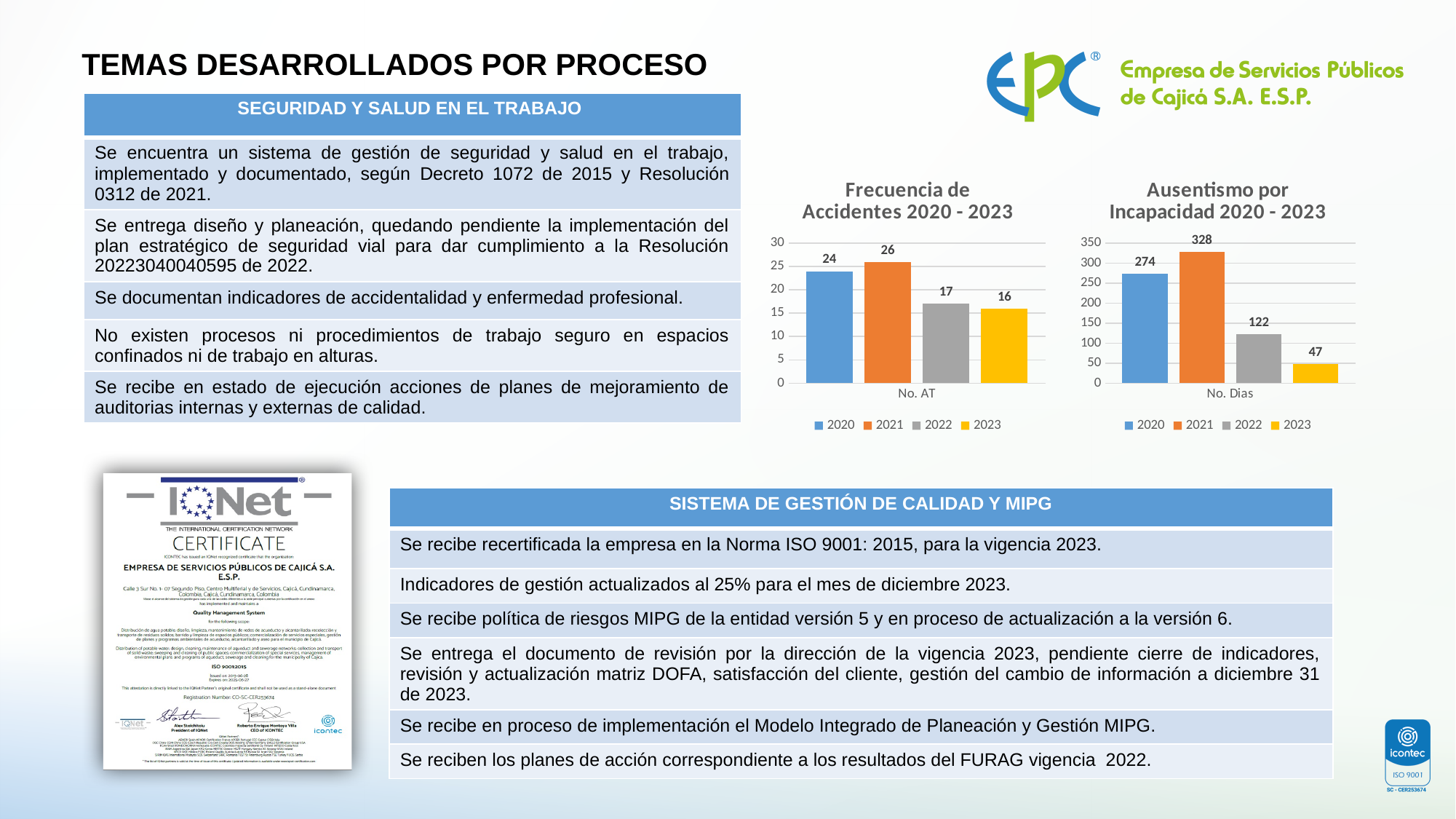
In the 'Frecuencia de Accidentes 2020 - 2023' chart, what is the value for 2021? 26 In the 'Ausentismo por Incapacidad 2020 - 2023' chart, which year has the highest value? 2021 In the 'Ausentismo por Incapacidad 2020 - 2023' chart, is the value for 2023 greater or less than 50? less In the 'Frecuencia de Accidentes 2020 - 2023' chart, which year has the lowest value? 2023 In the 'Frecuencia de Accidentes 2020 - 2023' chart, how many series does the legend list? 4 In the 'Ausentismo por Incapacidad 2020 - 2023' chart, what is the difference between the 2021 and 2020 values? 54 In the 'Ausentismo por Incapacidad 2020 - 2023' chart, which is larger, the value for 2022 or the value for 2023? 2022 In the 'Frecuencia de Accidentes 2020 - 2023' chart, what kind of chart is shown? Bar chart In the 'Ausentismo por Incapacidad 2020 - 2023' chart, what is the value for 2022? 122 In the 'Frecuencia de Accidentes 2020 - 2023' chart, what colour is the bar for 2023? Yellow In the 'Frecuencia de Accidentes 2020 - 2023' chart, what is the difference between the 2020 and 2023 values? 8 In the 'Ausentismo por Incapacidad 2020 - 2023' chart, what is the label on the x axis? No. Dias